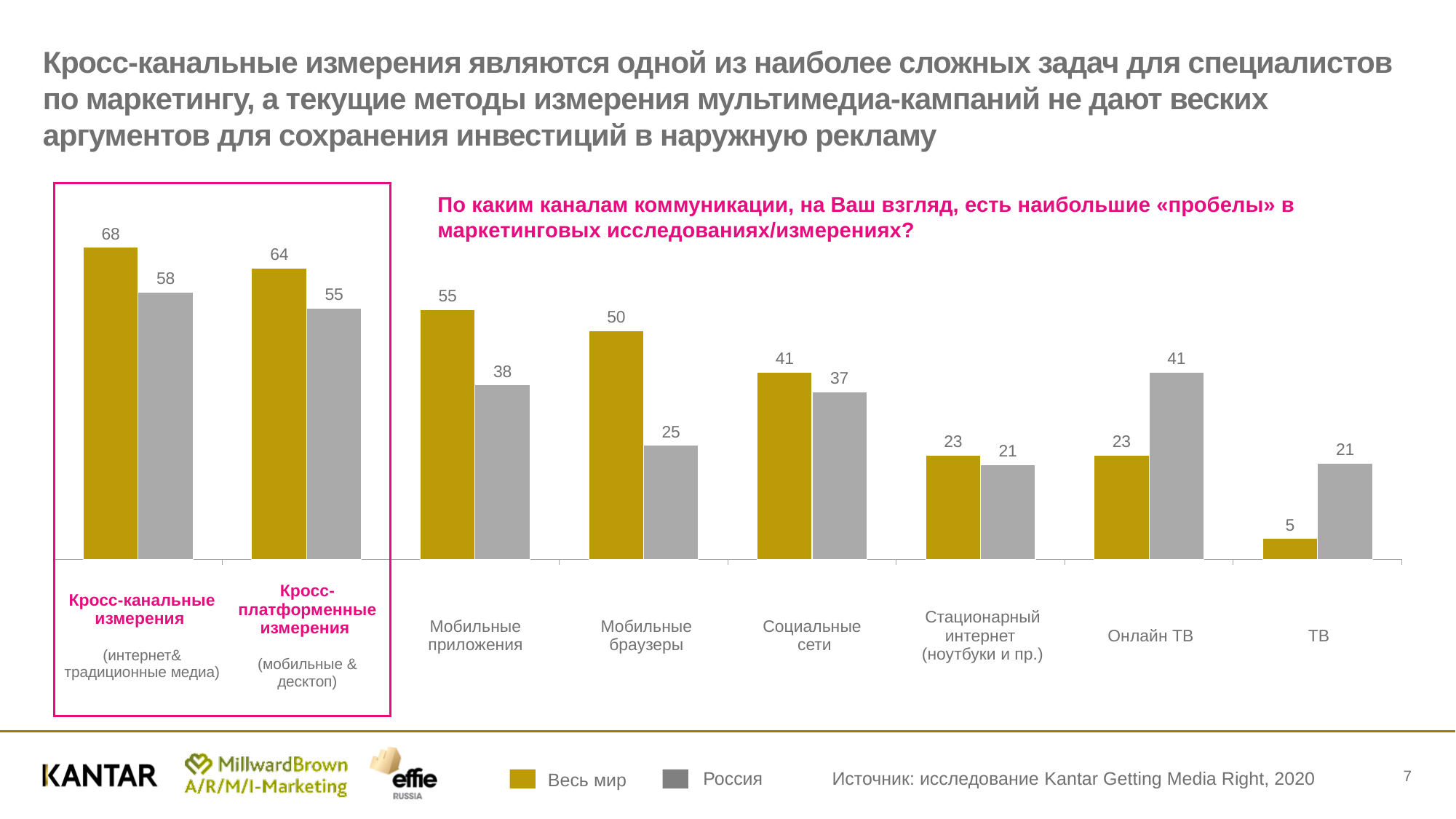
Which category has the highest value for "Россия"? Кросс-канальные измерения How many categories are shown on the x axis of the chart? 8 What is the difference between the "Весь мир" and "Россия" values for "Мобильные браузеры"? 25 What is the value for "Россия" for "Онлайн ТВ"? 41 Which category has the lowest value for "Весь мир"? ТВ Which colour represents the "Россия" series in the chart? Grey For "Онлайн ТВ", which series has the larger value, "Весь мир" or "Россия"? Россия What is the value for "Россия" for "Мобильные браузеры"? 25 What kind of chart is shown on the slide? Bar chart What is the difference between the "Весь мир" values for "Кросс-канальные измерения" and "Кросс-платформенные измерения"? 4 What is the value for "Весь мир" for "Кросс-канальные измерения"? 68 How many series does the legend list? 2